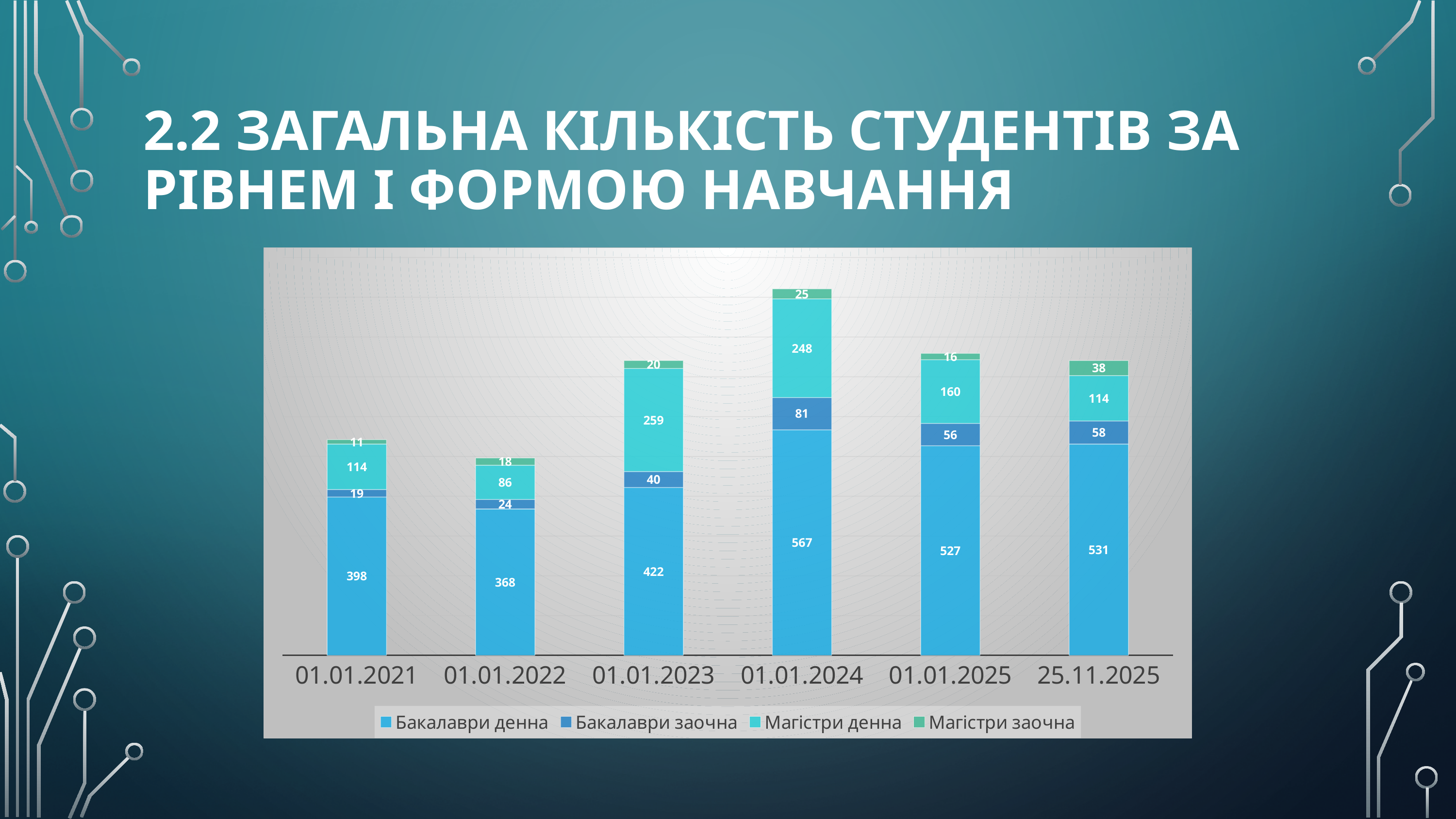
What is the value for Бакалаври денна on 01.01.2024? 567 What is the value for Магістри денна on 01.01.2023? 259 On which date is the value for Бакалаври денна the highest? 01.01.2024 On which date is the value for Бакалаври заочна the lowest? 01.01.2021 How many series does the legend list? 4 What type of chart is shown on the slide? stacked bar chart Which is larger: Магістри денна on 01.01.2022 or on 01.01.2025? 01.01.2025 What is the value for Магістри заочна on 25.11.2025? 38 How many dates (categories) are shown on the x axis? 6 What is the difference between the Бакалаври денна values on 01.01.2024 and 01.01.2025? 40 What is the total of the stacked bar for 01.01.2021? 542 What is the total of the stacked bar for 01.01.2024? 921